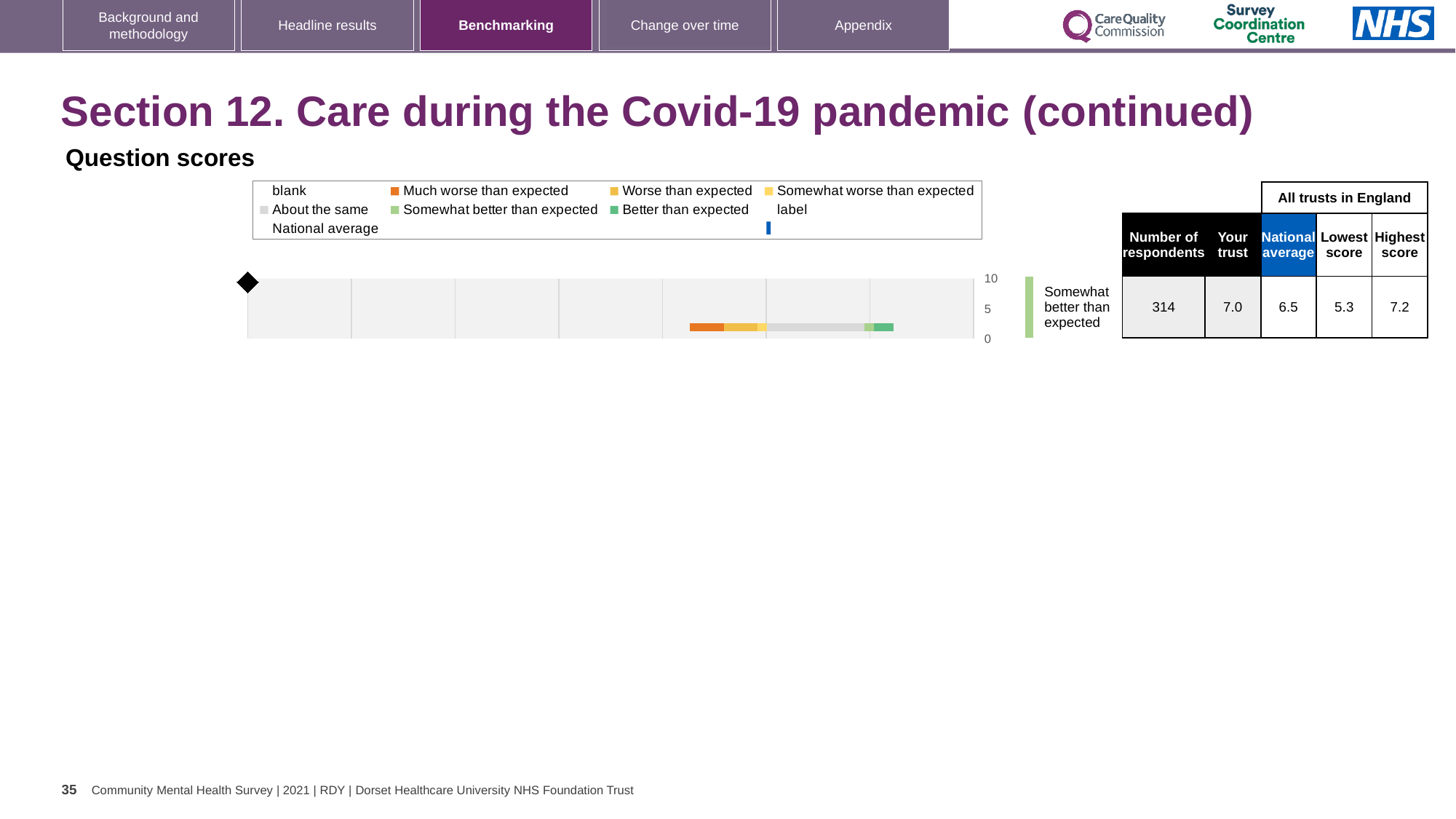
How many bars are plotted in the chart? 1 What is the category label shown beside the bar in the chart? Somewhat better than expected How many entries does the chart legend list? 9 In the table beside the chart, what is the 'Your trust' score? 7.0 In the table beside the chart, which is larger: the 'Your trust' score or the National average? Your trust Which colour in the legend represents 'Better than expected'? green Which colour in the legend represents 'Much worse than expected'? orange What kind of chart is shown under 'Question scores'? bar chart In the table beside the chart, what is the Lowest score among all trusts in England? 5.3 In the table beside the chart, what is the National average score? 6.5 In the table beside the chart, what is the Highest score among all trusts in England? 7.2 In the table beside the chart, what is the difference between the Highest score and the Lowest score? 1.9